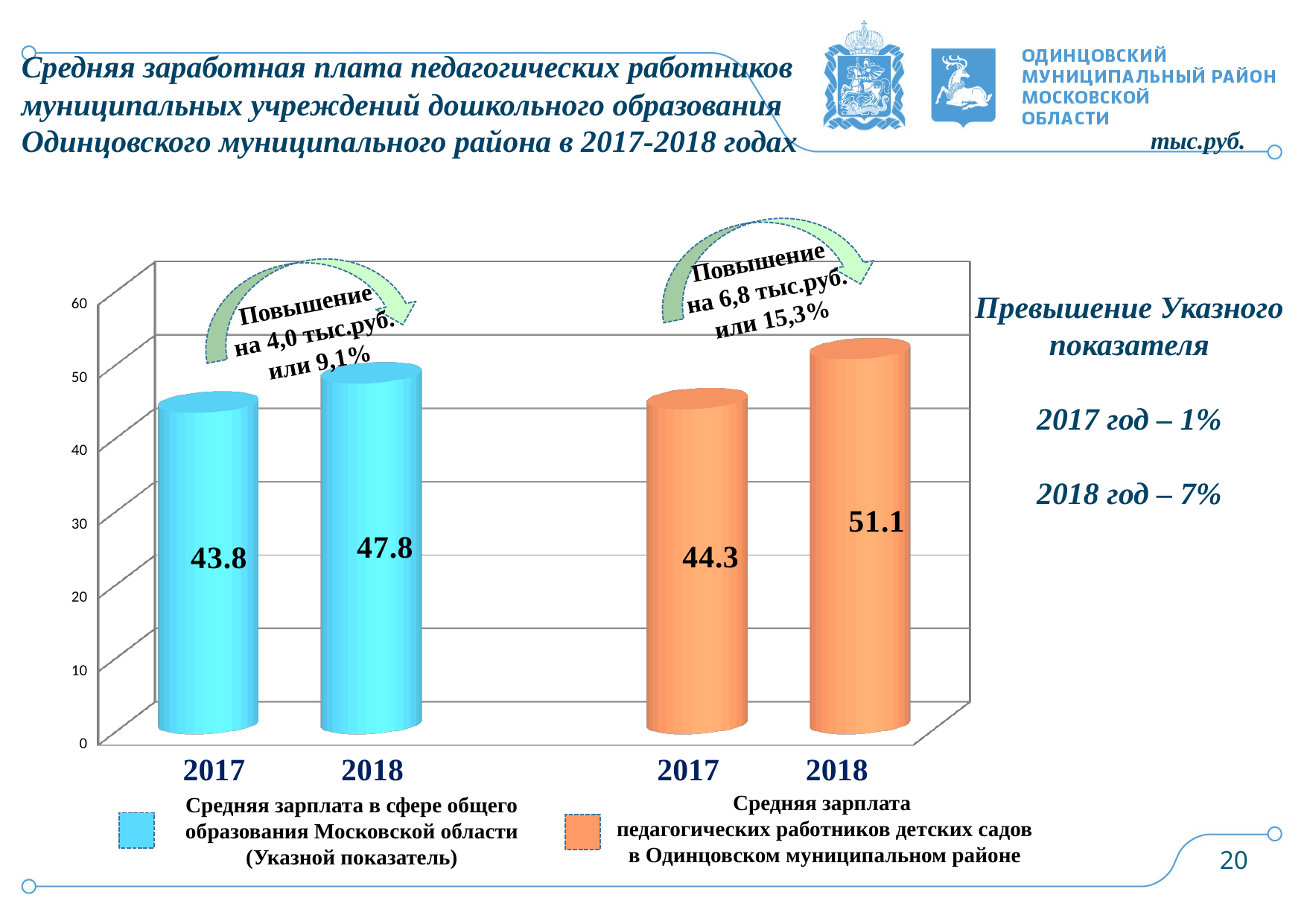
What is the difference between the 2018 and 2017 values for the 'Указной показатель' series? 4.0 What is the value for 2018 in the series 'Средняя зарплата педагогических работников детских садов в Одинцовском муниципальном районе'? 51.1 Which is larger in 2017: the 'Указной показатель' value or the Одинцовский муниципальный район value? Одинцовский муниципальный район (44.3) Which bar has the lowest value on the chart? 2017, Средняя зарплата в сфере общего образования Московской области (Указной показатель) (43.8) What is the value for 2017 in the series 'Средняя зарплата в сфере общего образования Московской области (Указной показатель)'? 43.8 Do the values rise or fall from 2017 to 2018 for the Одинцовский муниципальный район series? rise What is the value for 2017 in the series 'Средняя зарплата педагогических работников детских садов в Одинцовском муниципальном районе'? 44.3 What is the difference between the 2018 values of the two series? 3.3 What kind of chart is shown on the slide? bar chart Which bar has the highest value on the chart? 2018, Средняя зарплата педагогических работников детских садов в Одинцовском муниципальном районе (51.1) How many series does the legend list? 2 Is the 2018 value for the Одинцовский муниципальный район series greater or less than 50? greater